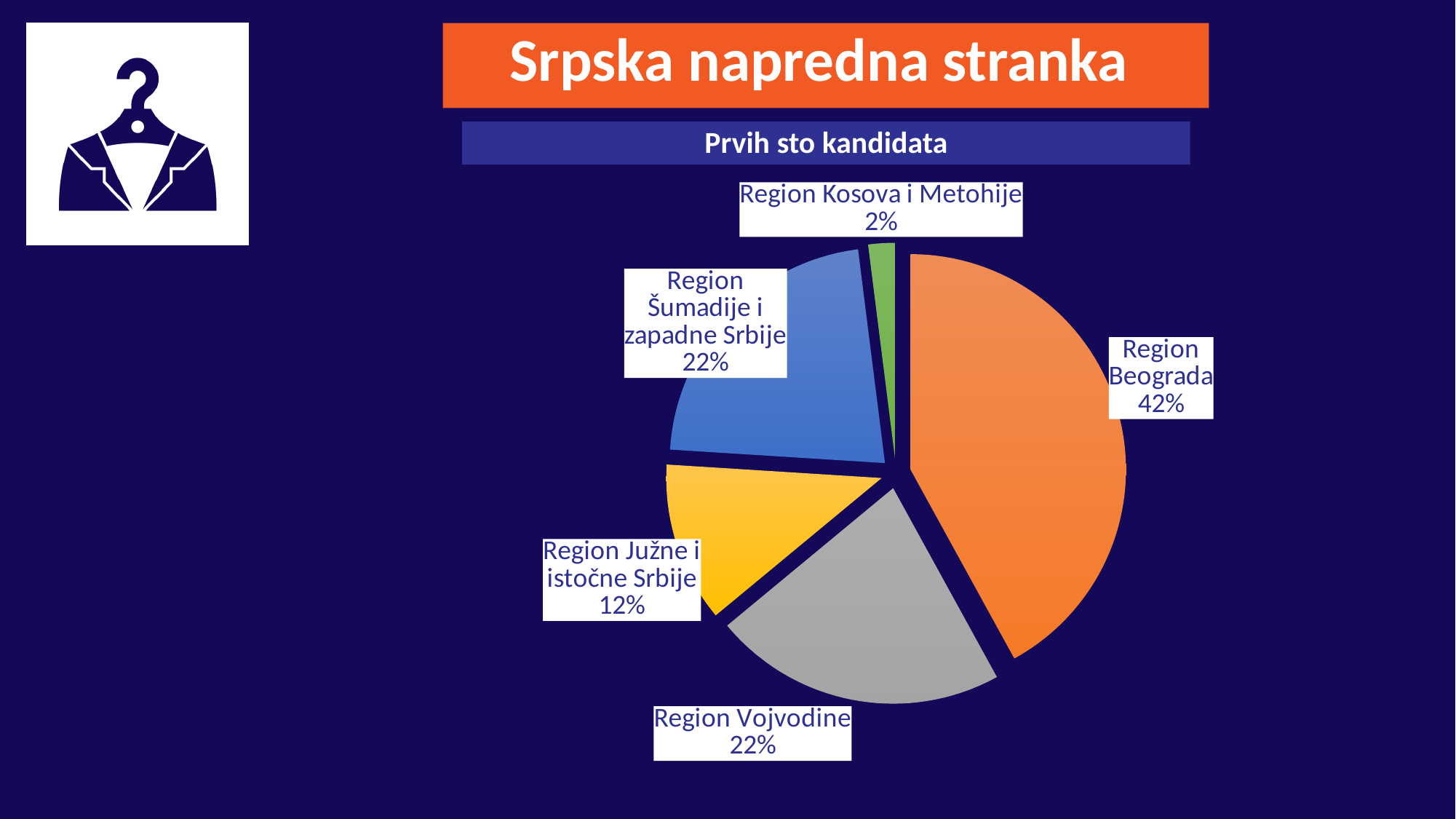
Which region has the smallest slice of the pie? Region Kosova i Metohije What is the combined share of Region Vojvodine and Region Šumadije i zapadne Srbije? 44% What is the difference in percentage points between Region Beograda and Region Vojvodine? 20 What type of chart is shown on the slide? pie chart What is the subtitle shown above the pie chart? Prvih sto kandidata What percentage is shown for Region Južne i istočne Srbije? 12% Which region has the largest slice of the pie? Region Beograda Which is larger: the share for Region Šumadije i zapadne Srbije or the share for Region Južne i istočne Srbije? Region Šumadije i zapadne Srbije What percentage is shown for Region Kosova i Metohije? 2% What percentage is shown for Region Vojvodine? 22% What share of the first hundred candidates comes from Region Beograda? 42% How many regions (slices) does the pie chart show? 5